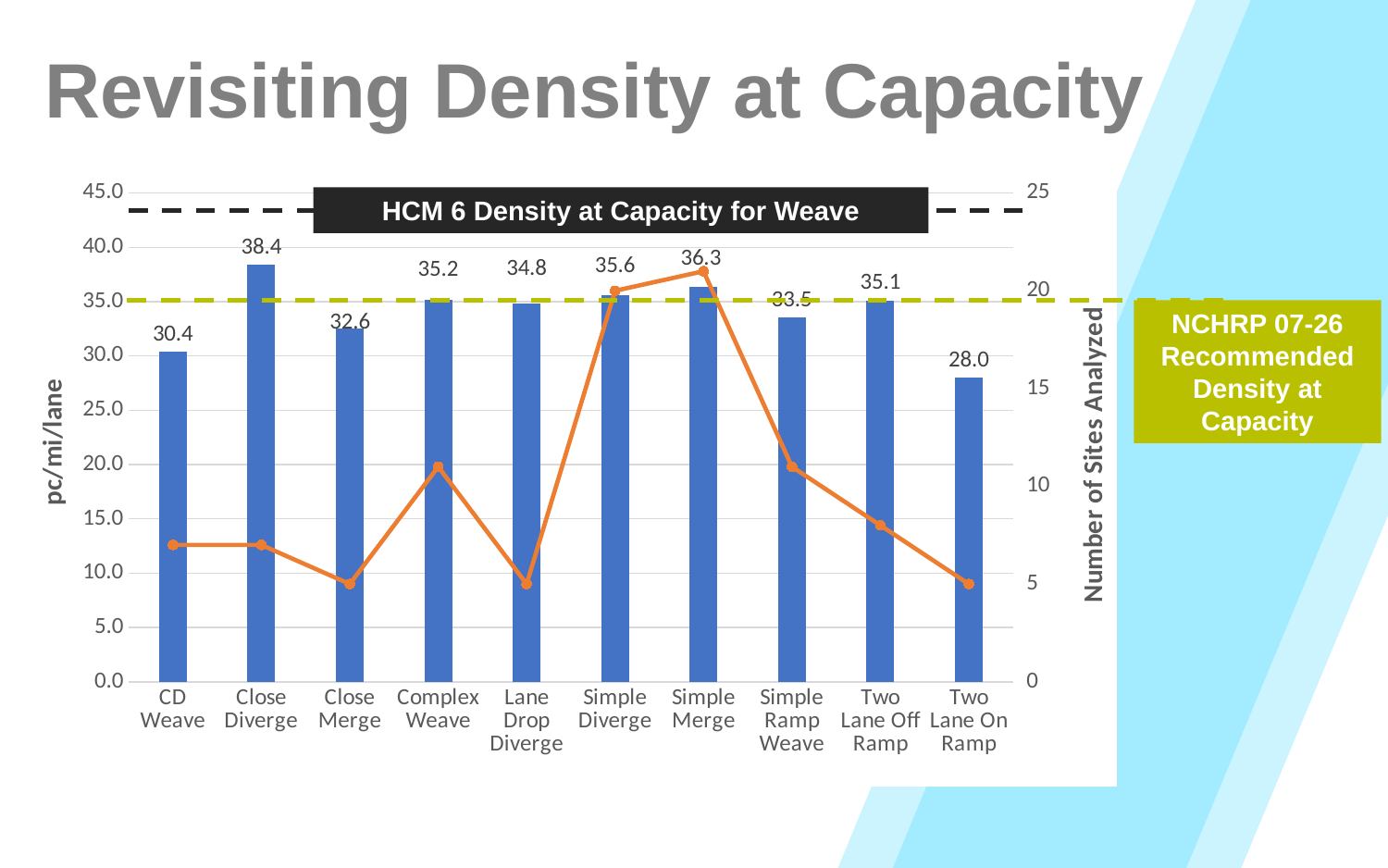
Which has a higher density at capacity, CD Weave or Close Merge? Close Merge What is the difference between the density values for Close Diverge and Two Lane On Ramp? 10.4 What is the density at capacity value for Two Lane On Ramp? 28.0 What kind of chart is used to show the density at capacity values? bar chart Which category has the highest density at capacity bar? Close Diverge Is the number of sites analyzed for Simple Merge greater or less than 15? greater Is the number of sites analyzed for Close Merge greater or less than 10? less How many categories are shown on the x axis of the chart? 10 Which category has the lowest density at capacity bar? Two Lane On Ramp What is the density at capacity value for Simple Merge? 36.3 What is the label of the right-hand vertical axis? Number of Sites Analyzed What is the density at capacity value for Close Diverge? 38.4